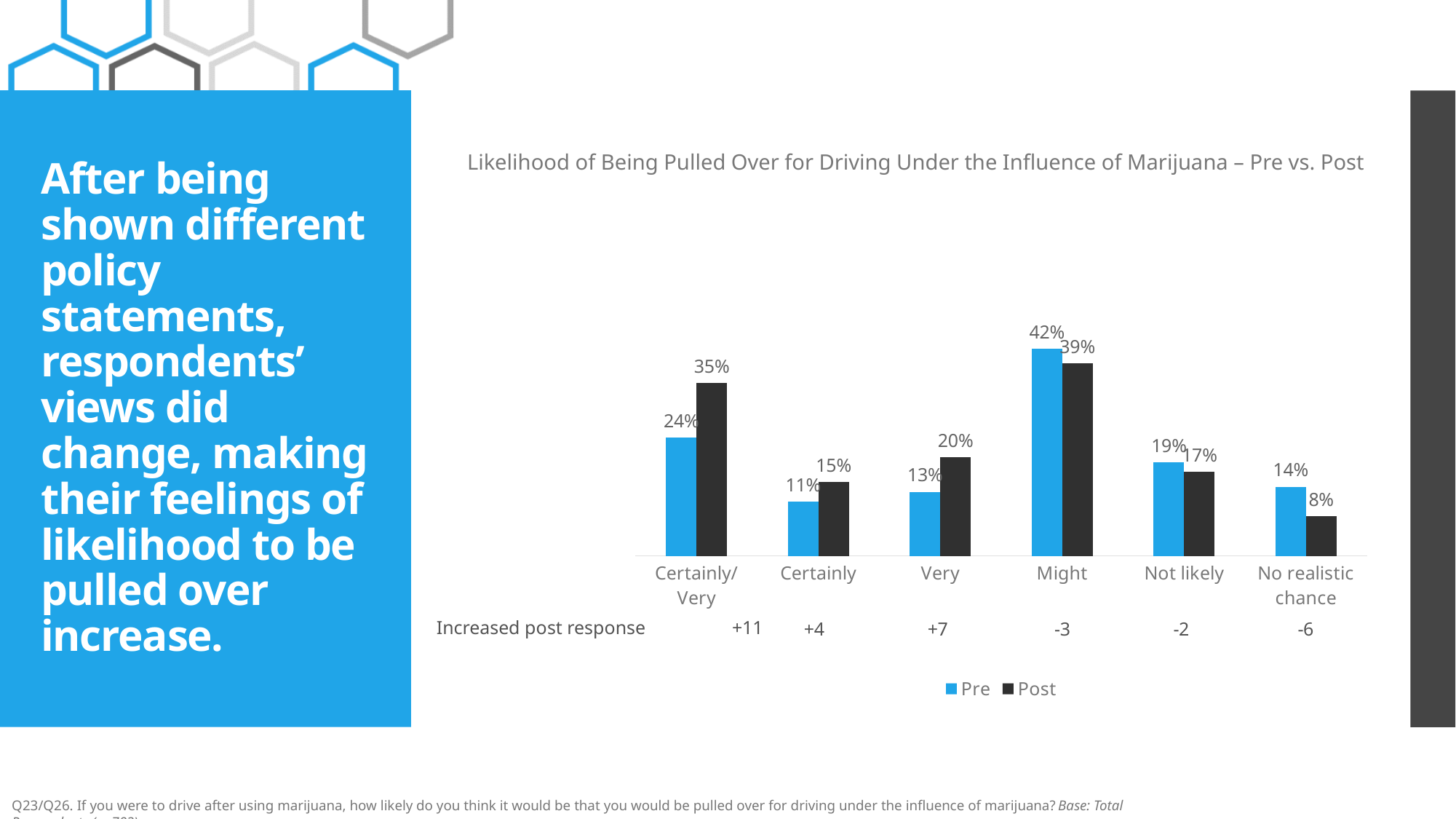
What kind of chart is shown on the slide? Bar chart How many series does the legend list? 2 What is the Post value for Might? 39% Which category has the lowest Post value? No realistic chance What is the difference between the Post and Pre values for Certainly/Very? 11 percentage points What is the Pre value for Certainly/Very? 24% How many categories are shown on the x axis? 6 What is the title of the chart? Likelihood of Being Pulled Over for Driving Under the Influence of Marijuana – Pre vs. Post Which is larger for Very, the Pre value or the Post value? Post What is the 'Increased post response' value shown for Not likely? -2 Which category has the highest Pre value? Might What is the Post value for No realistic chance? 8%